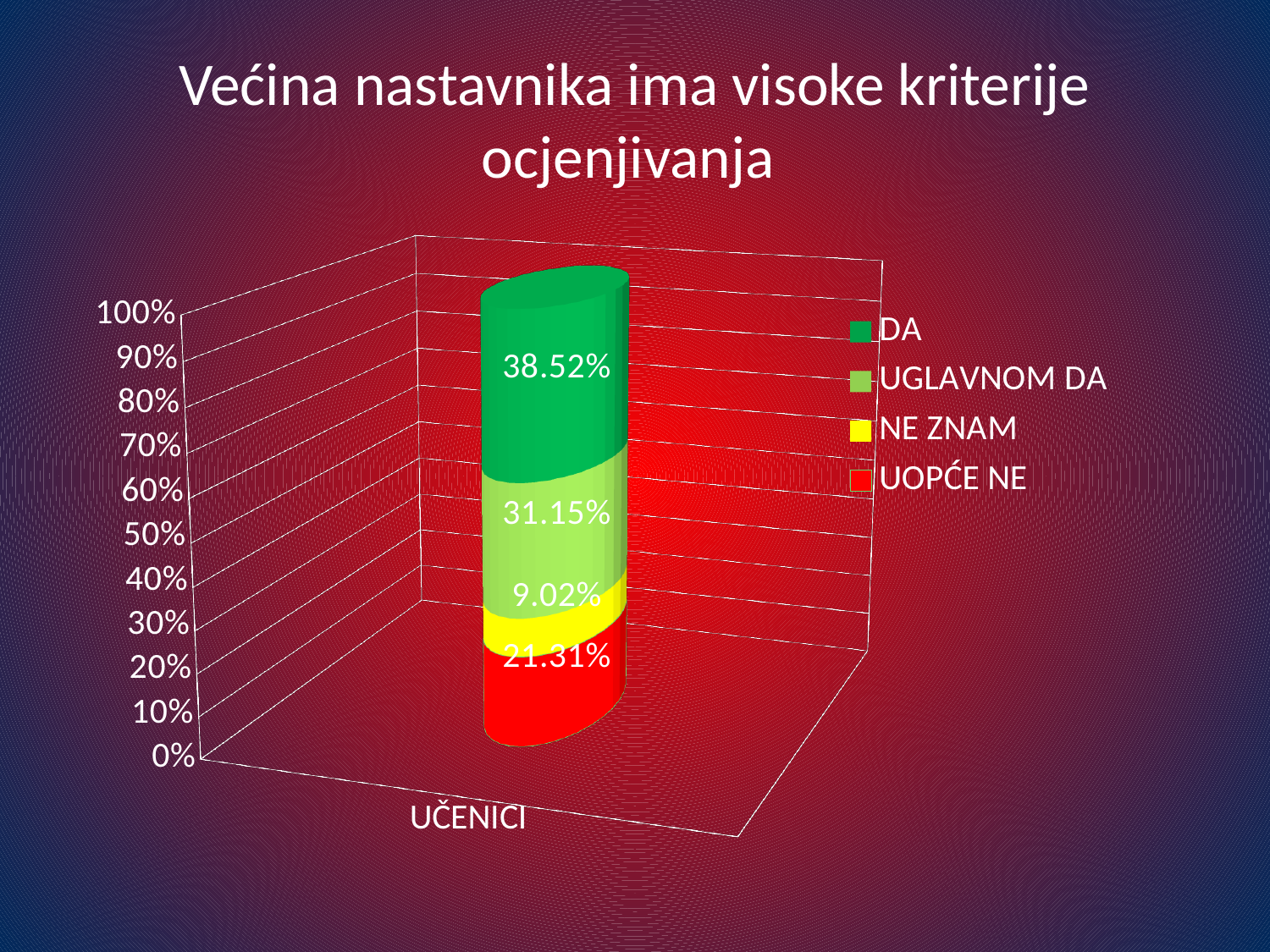
How many series does the legend list? 4 Which series has the lowest value in the UČENICI bar? NE ZNAM What is the title of the slide? Većina nastavnika ima visoke kriterije ocjenjivanja How many categories are shown on the x axis? 1 What is the value for DA in the UČENICI bar? 38.52% What is the difference between the DA and UGLAVNOM DA values? 7.37% What kind of chart is shown on the slide? Stacked bar chart Which is larger, the value for UOPĆE NE or the value for NE ZNAM? UOPĆE NE What is the value for UOPĆE NE in the UČENICI bar? 21.31% What is the value for NE ZNAM in the UČENICI bar? 9.02% What is the value for UGLAVNOM DA in the UČENICI bar? 31.15% Which series has the highest value in the UČENICI bar? DA